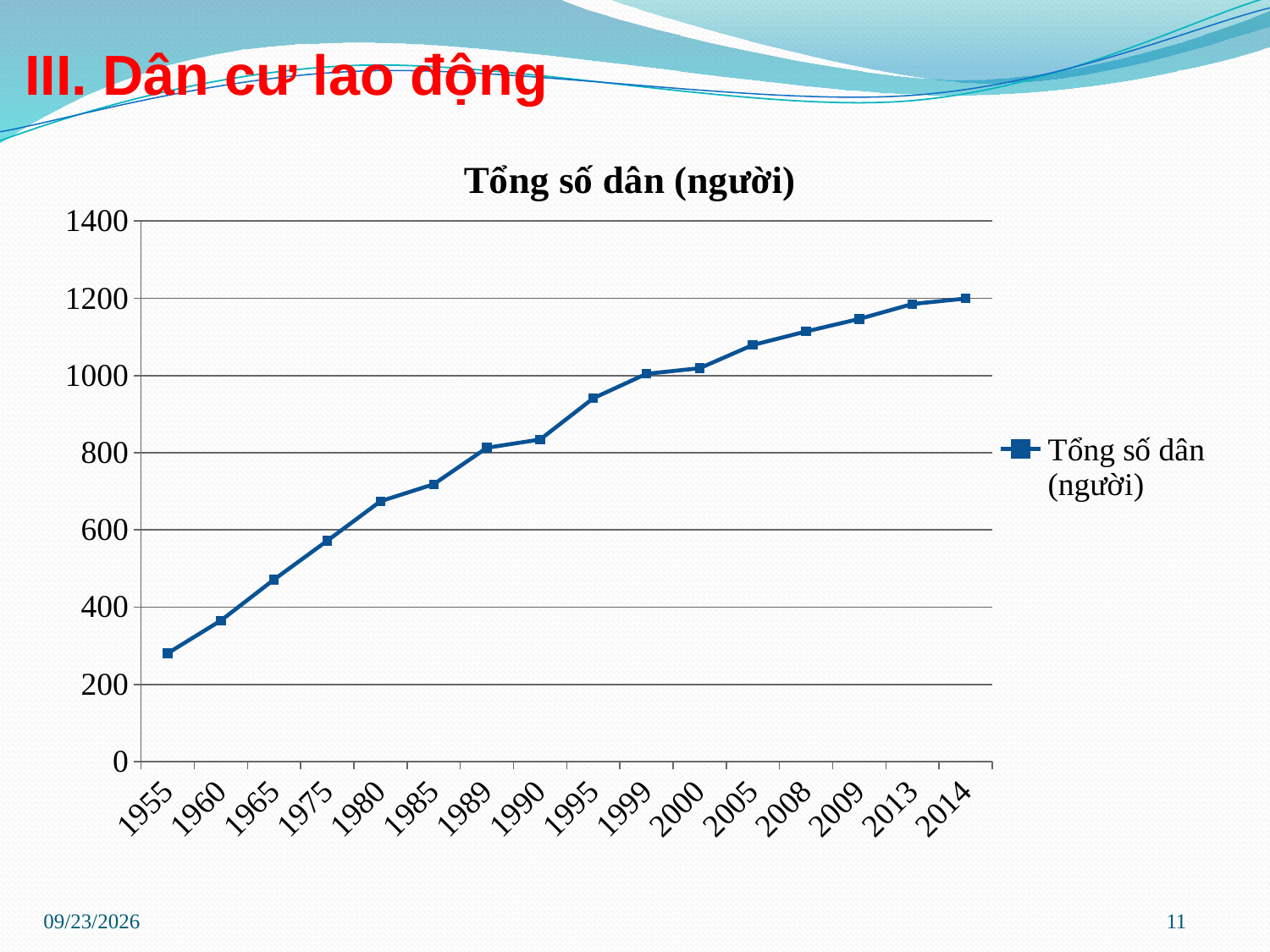
Which is larger, the value for 1975 or the value for 1990? 1990 Is the value for 1955 greater or less than 400? less Do the values rise or fall from 1955 to 2014? rise Is the value for 2005 greater or less than 1000? greater Is the value for 1995 greater or less than 1000? less What is the title of the chart? Tổng số dân (người) What kind of chart is shown on the slide? line chart Which year has the highest value for Tổng số dân (người)? 2014 How many series does the legend list? 1 How many years are plotted along the x axis? 16 Which year has the lowest value for Tổng số dân (người)? 1955